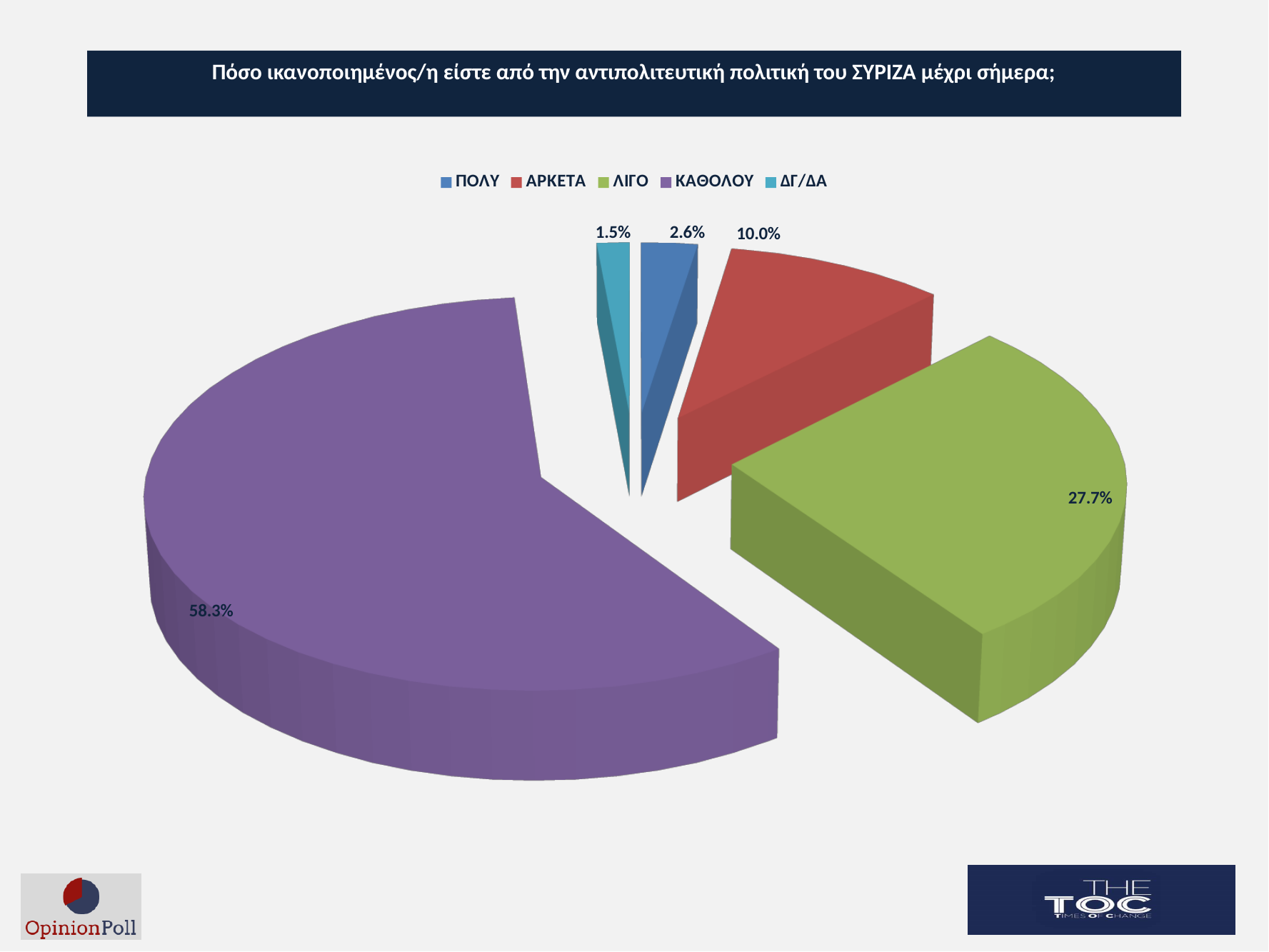
Which response has the largest share of the pie? ΚΑΘΟΛΟΥ What percentage of respondents answered ΚΑΘΟΛΟΥ? 58.3% What percentage of respondents answered ΔΓ/ΔΑ? 1.5% What percentage of respondents answered ΠΟΛΥ? 2.6% What colour is the ΚΑΘΟΛΟΥ slice? Purple Which response has the smallest share of the pie? ΔΓ/ΔΑ What percentage of respondents answered ΑΡΚΕΤΑ? 10.0% What kind of chart is shown on the slide? Pie chart How many categories does the legend list? 5 What is the difference in percentage points between ΚΑΘΟΛΟΥ and ΛΙΓΟ? 30.6 Which is larger, the share for ΑΡΚΕΤΑ or the share for ΠΟΛΥ? ΑΡΚΕΤΑ What percentage of respondents answered ΛΙΓΟ? 27.7%